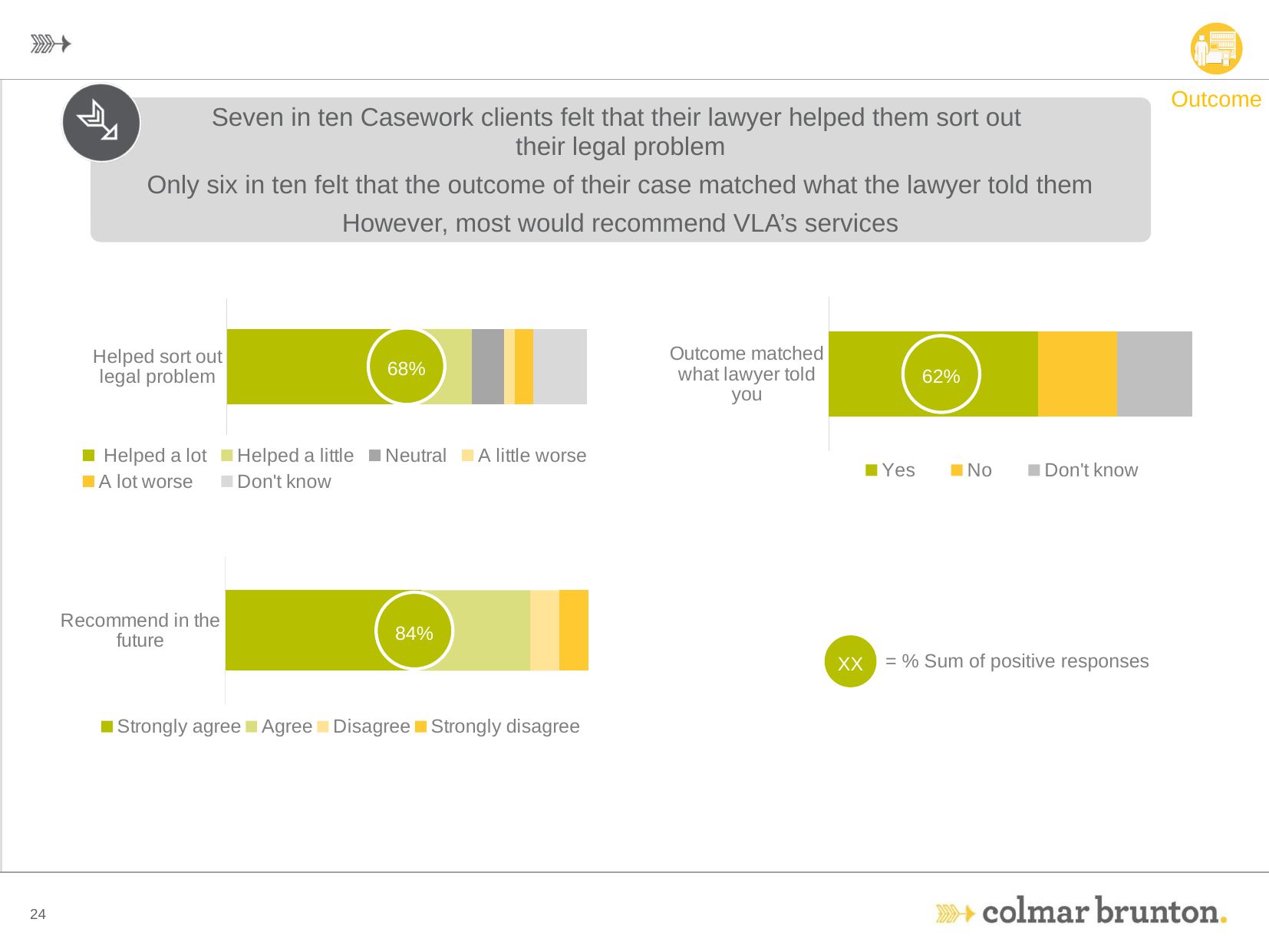
In the 'Recommend in the future' chart, which segment is larger, 'Strongly agree' or 'Agree'? Strongly agree How many series does the legend list for the 'Recommend in the future' chart? 4 In the 'Outcome matched what lawyer told you' chart, which segment is larger, 'Yes' or 'No'? Yes How many series does the legend list for the 'Helped sort out legal problem' chart? 6 In the 'Helped sort out legal problem' chart, what is the percentage sum of positive responses shown in the circle? 68% What kind of chart is the 'Recommend in the future' chart? Stacked bar chart Across the three charts, which measure has the lowest sum of positive responses? Outcome matched what lawyer told you In the 'Outcome matched what lawyer told you' chart, what is the percentage sum of positive responses shown in the circle? 62% How many series does the legend list for the 'Outcome matched what lawyer told you' chart? 3 Across the three charts, which measure has the highest sum of positive responses? Recommend in the future What is the difference between the positive response sums for 'Recommend in the future' and 'Helped sort out legal problem'? 16 percentage points In the 'Recommend in the future' chart, what is the percentage sum of positive responses shown in the circle? 84%